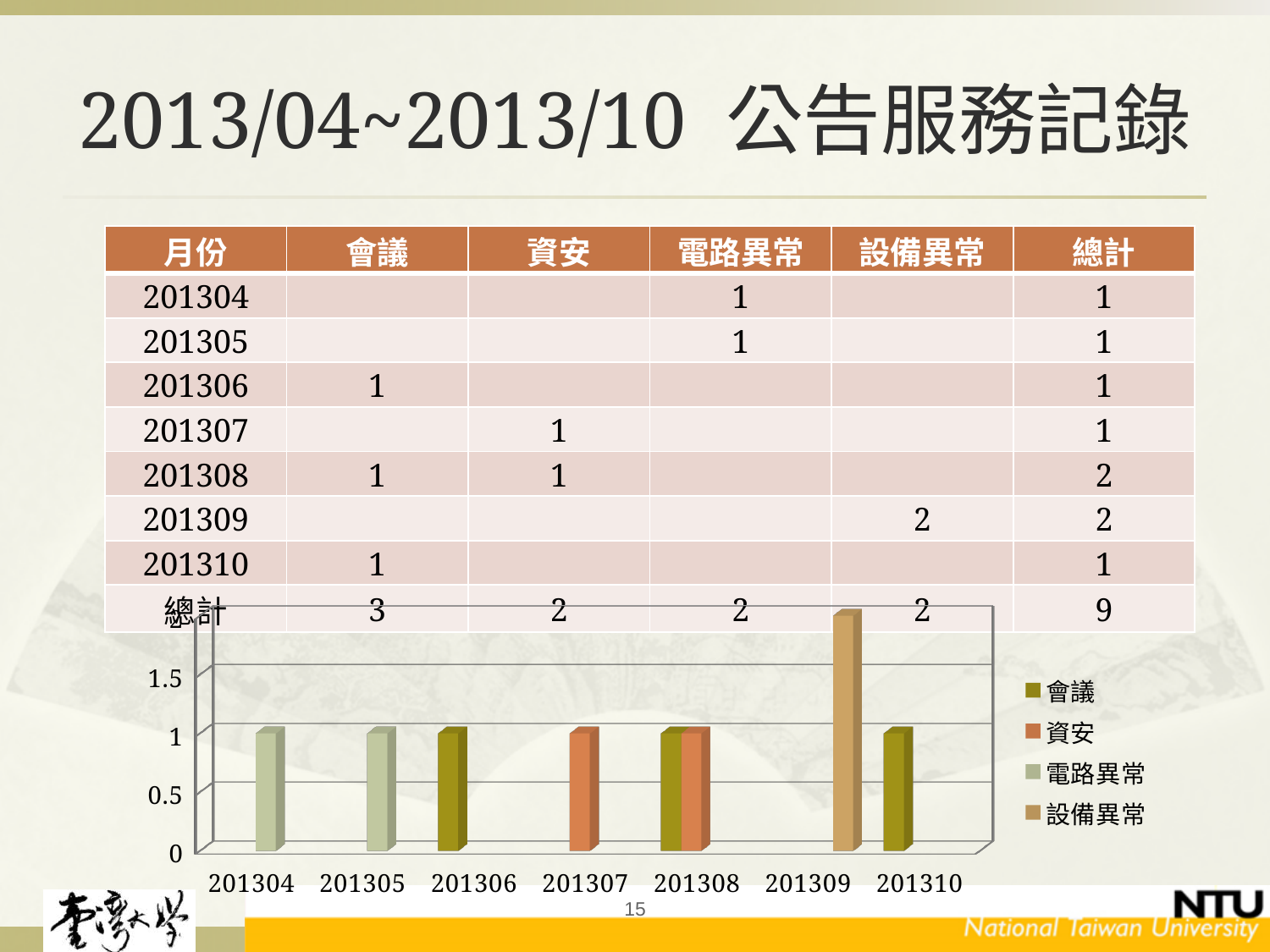
How many series does the chart legend list? 4 Which month shows bars for two different series in the chart? 201308 Is the 設備異常 bar for 201309 greater or less than 1.5? greater Which series has a bar in both 201304 and 201305? 電路異常 How many months are shown along the x axis of the chart? 7 What is the difference between the 設備異常 value for 201309 and the 會議 value for 201308? 1 What is the value of 設備異常 for 201309 in the chart? 2 Which month has the tallest bar in the chart? 201309 What is the value of 資安 for 201307 in the chart? 1 What is the value of 電路異常 for 201304 in the chart? 1 What kind of chart is shown on the slide? bar chart Which is larger: the 設備異常 value for 201309 or the 會議 value for 201310? 設備異常 for 201309